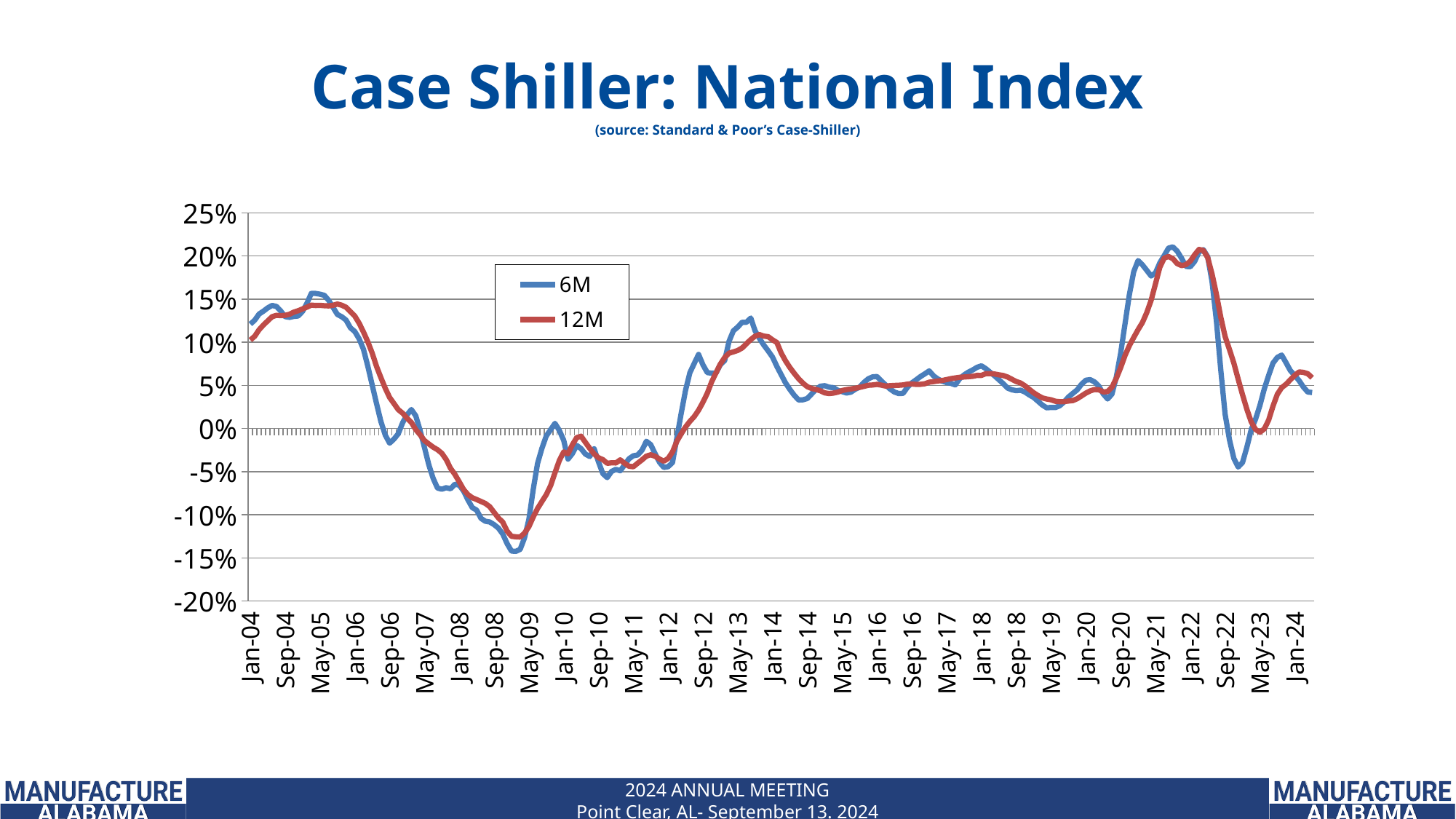
Is the value of the 6M series at May-21 greater or less than 15%? greater Is the value of the 6M series at Sep-22 greater or less than 0%? greater Does the 6M series rise or fall between Jan-22 and Sep-22? fall Is the value of the 12M series at Jan-04 greater or less than 5%? greater Which colour is used for the 12M series? red How many series does the legend list? 2 At Sep-22, which series has the higher value, 6M or 12M? 12M What are the two series named in the legend? 6M and 12M What kind of chart is shown on the slide? line chart Near which x-axis label does the 6M series reach its lowest value? May-09